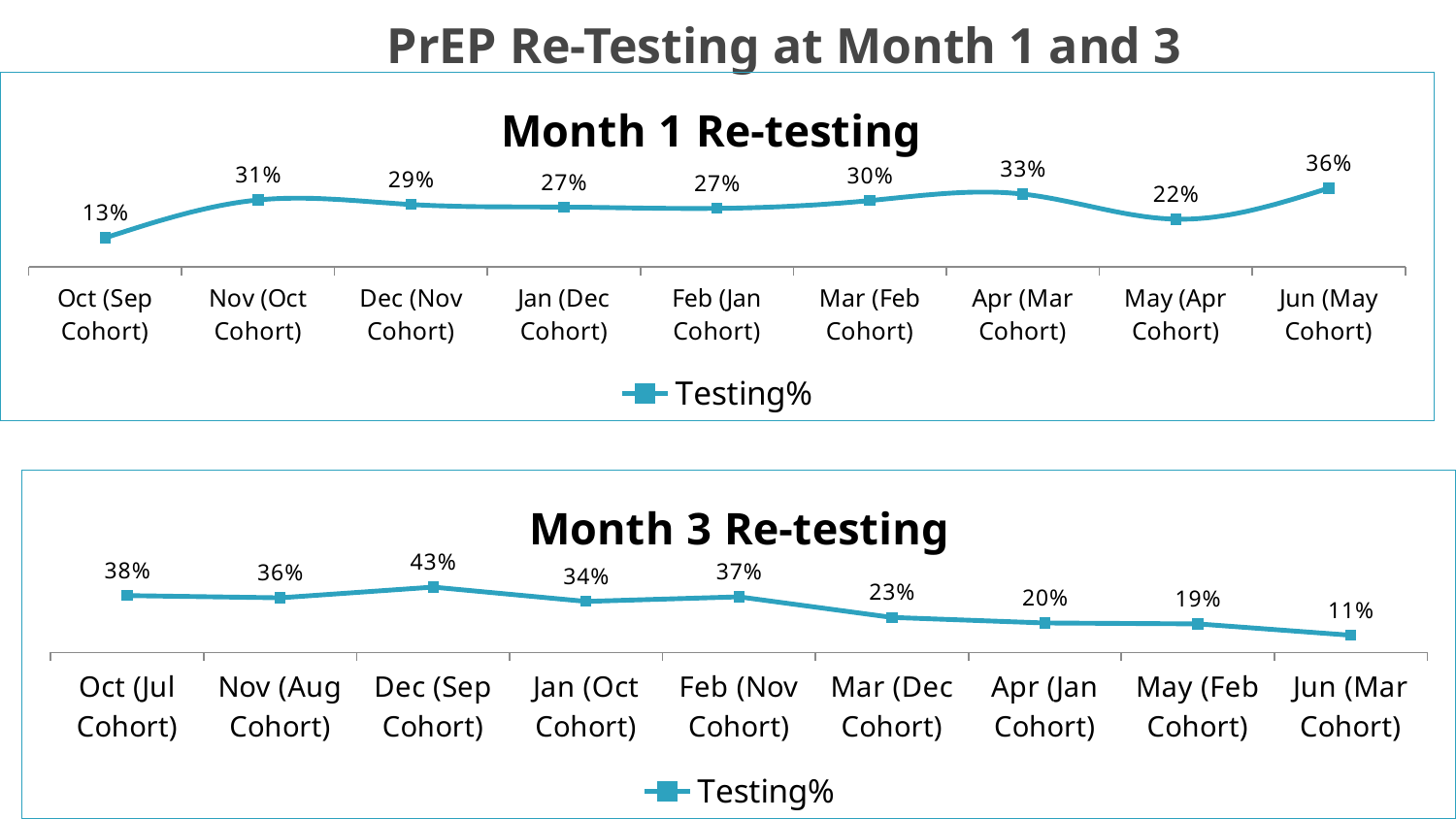
In the Month 1 Re-testing chart, which category has the highest Testing% value? Jun (May Cohort) In the Month 3 Re-testing chart, what is the difference between the Testing% values for Oct (Jul Cohort) and Jun (Mar Cohort)? 27% What type of chart is the Month 3 Re-testing chart? line chart In the Month 1 Re-testing chart, what is the Testing% value for Oct (Sep Cohort)? 13% In the Month 3 Re-testing chart, which category has the highest Testing% value? Dec (Sep Cohort) In the Month 3 Re-testing chart, which category has the lowest Testing% value? Jun (Mar Cohort) In the Month 3 Re-testing chart, do the Testing% values generally rise or fall from Feb (Nov Cohort) to Jun (Mar Cohort)? fall In the Month 3 Re-testing chart, what is the Testing% value for Dec (Sep Cohort)? 43% In the Month 3 Re-testing chart, which is larger: the Testing% for Feb (Nov Cohort) or Mar (Dec Cohort)? Feb (Nov Cohort) In the Month 1 Re-testing chart, what is the difference between the Testing% values for Jun (May Cohort) and May (Apr Cohort)? 14% In the Month 1 Re-testing chart, how many categories are plotted on the x axis? 9 In the Month 1 Re-testing chart, which category has the lowest Testing% value? Oct (Sep Cohort)